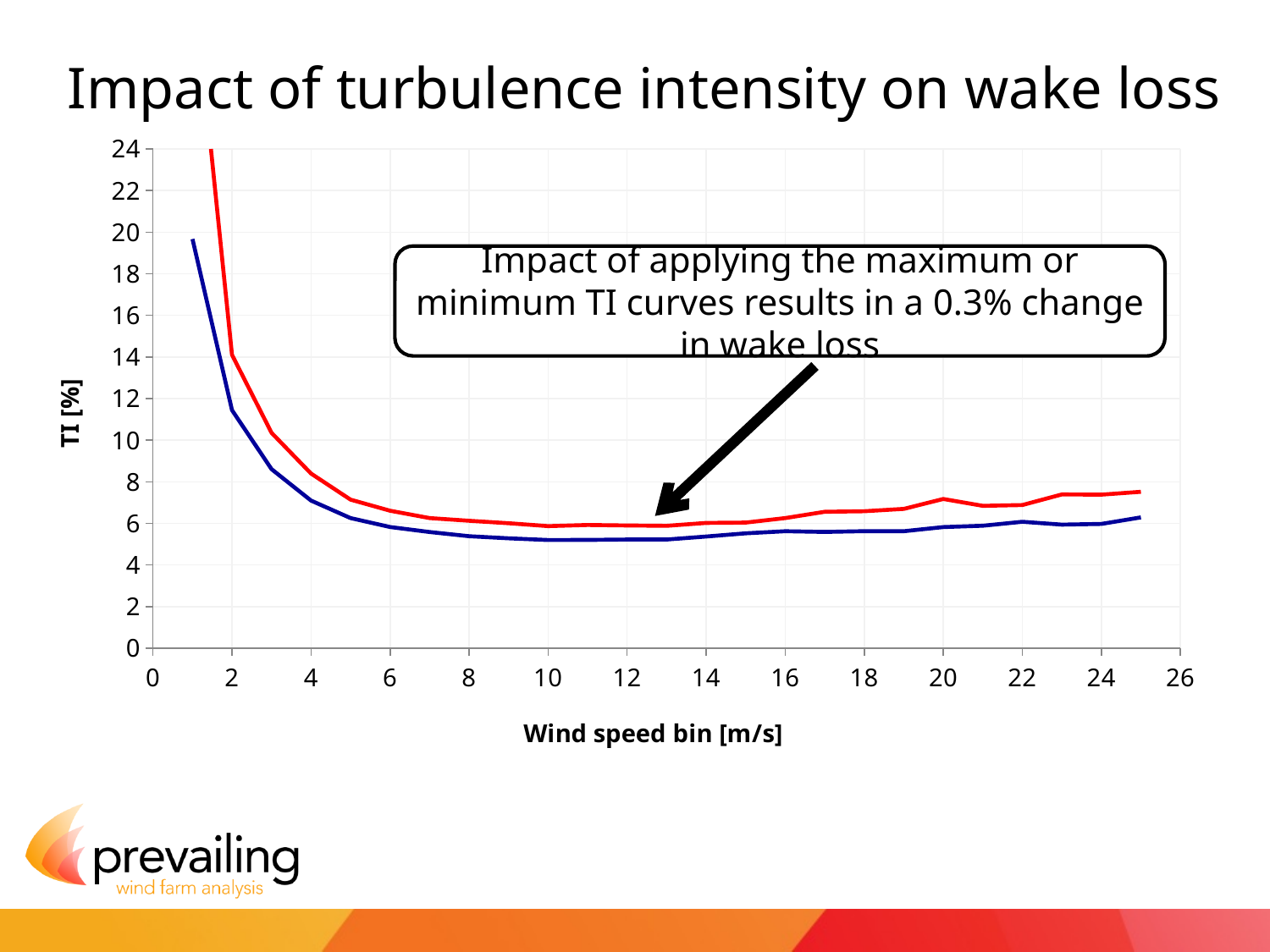
Between wind speed bins 2 and 8 m/s, do the TI values rise or fall? Fall What kind of chart is shown on the slide? Line chart Is the TI value of the red line at a wind speed bin of 2 m/s greater or less than 12? greater Is the TI value of the blue line at a wind speed bin of 2 m/s greater or less than 10? greater What is the title of the chart's y axis? TI [%] At a wind speed bin of 2 m/s, which line has the higher TI value, the red line or the blue line? The red line What is the title of the chart's x axis? Wind speed bin [m/s] Is the TI value of the blue line at a wind speed bin of 1 m/s greater or less than 18? greater How many lines are plotted on the chart? 2